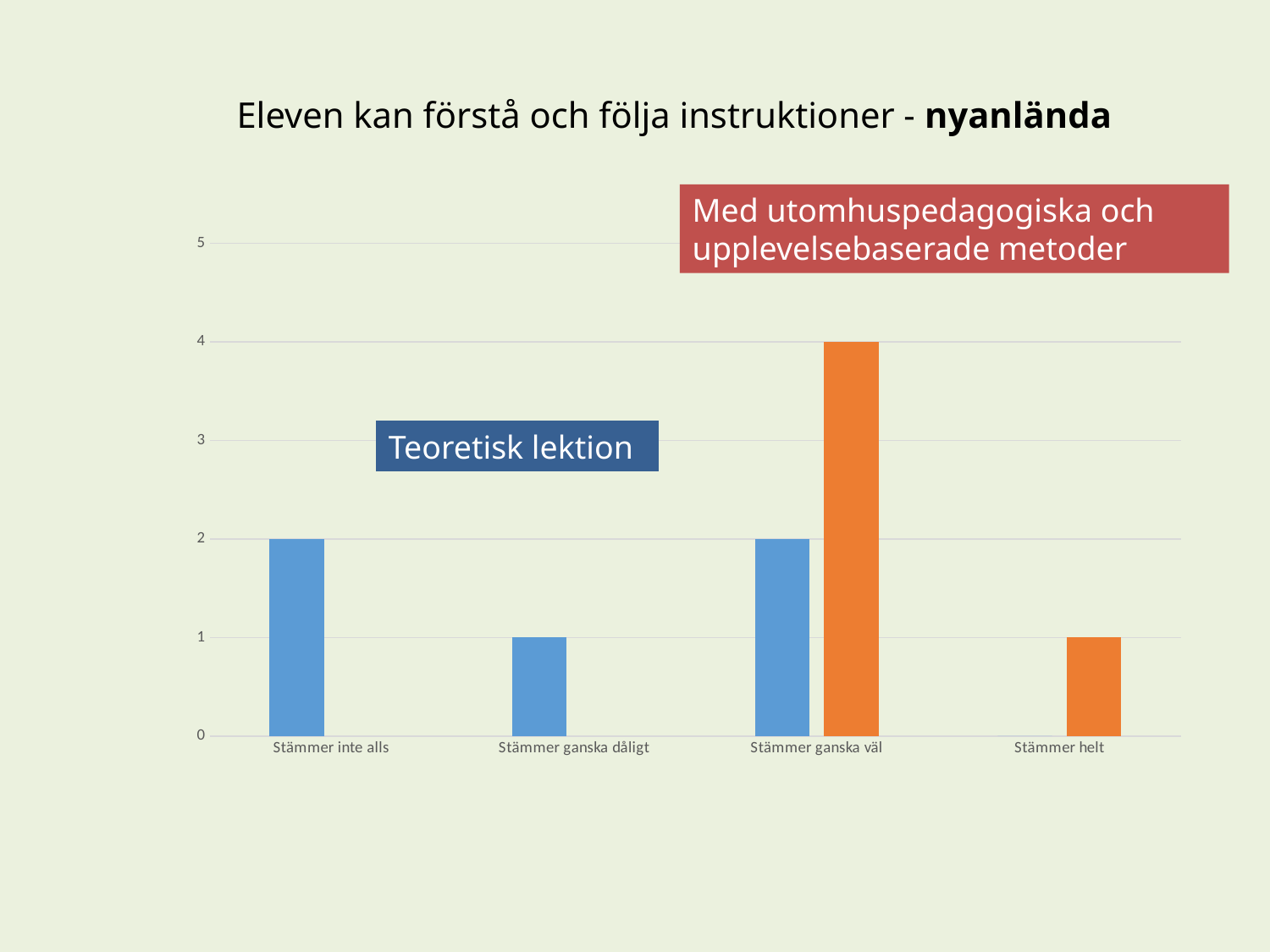
For Stämmer ganska väl, what is the difference between the Med utomhuspedagogiska och upplevelsebaserade metoder bar and the Teoretisk lektion bar? 2 What is the value of the Med utomhuspedagogiska och upplevelsebaserade metoder bar for Stämmer ganska väl? 4 What is the value of the Teoretisk lektion bar for Stämmer ganska dåligt? 1 What is the value of the Med utomhuspedagogiska och upplevelsebaserade metoder bar for Stämmer helt? 1 Is the value of the Med utomhuspedagogiska och upplevelsebaserade metoder bar for Stämmer ganska väl greater or less than 3? greater How many categories are shown on the x axis? 4 What is the title of the chart? Eleven kan förstå och följa instruktioner - nyanlända Which category has the highest bar in the chart? Stämmer ganska väl What type of chart is shown on the slide? bar chart What is the value of the Teoretisk lektion bar for Stämmer inte alls? 2 For Stämmer ganska väl, which is larger: the Teoretisk lektion bar or the Med utomhuspedagogiska och upplevelsebaserade metoder bar? Med utomhuspedagogiska och upplevelsebaserade metoder What colour are the Teoretisk lektion bars? blue